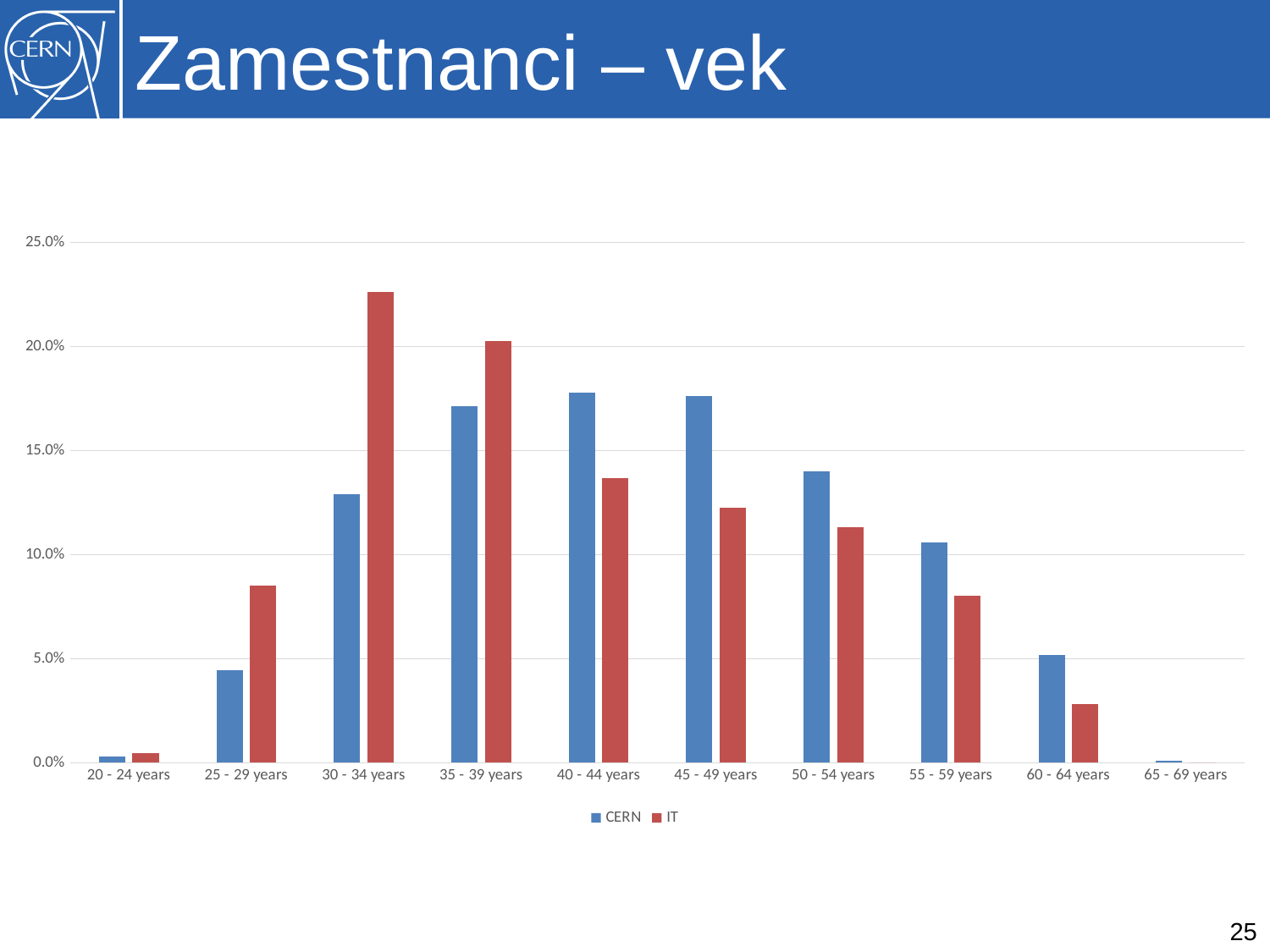
Which age category has the lowest value for the CERN series? 65 - 69 years Do the CERN values rise or fall from 45 - 49 years to 65 - 69 years? fall Is the IT value for 25 - 29 years greater or less than 10.0%? less How many age categories are shown on the x axis? 10 Which age category has the highest value for the IT series? 30 - 34 years Is the CERN value for 55 - 59 years greater or less than 10.0%? greater What kind of chart is shown on the slide? bar chart For 25 - 29 years, which series has the larger value, CERN or IT? IT Is the CERN value for 30 - 34 years greater or less than 15.0%? less How many series does the legend list? 2 For 50 - 54 years, which series has the larger value, CERN or IT? CERN